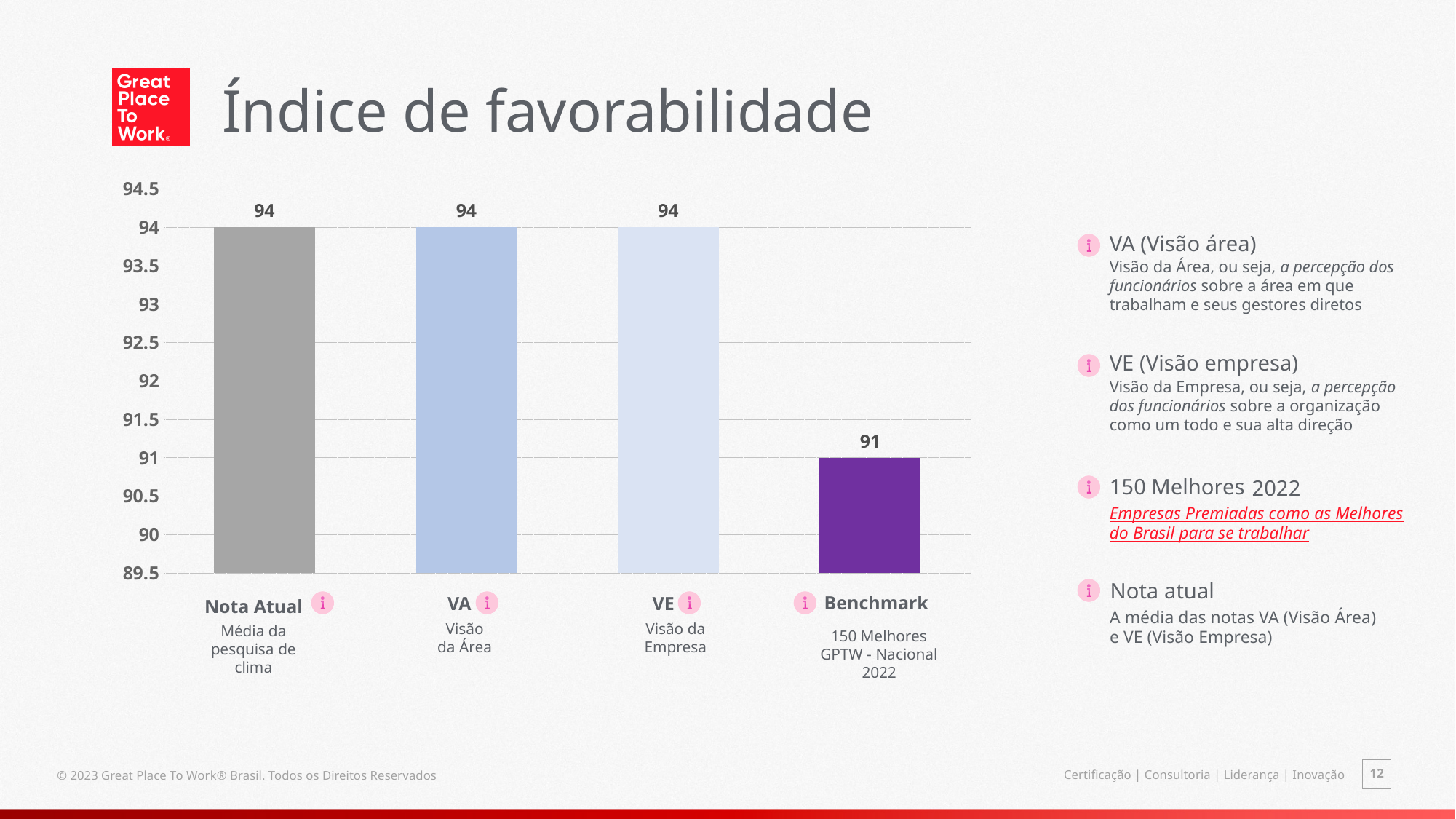
What is the difference between the value for Nota Atual and the value for Benchmark? 3 What colour is the Benchmark bar? purple What is the title of the slide containing the chart? Índice de favorabilidade What is the value for Nota Atual? 94 What kind of chart is shown on the slide? bar chart Is the value for Benchmark greater or less than 92? less How many bars are shown in the chart? 4 What is the value for VA? 94 What is the value for Benchmark? 91 Which is larger, the value for VE or the value for Benchmark? VE Which category has the lowest value? Benchmark What is the value for VE? 94